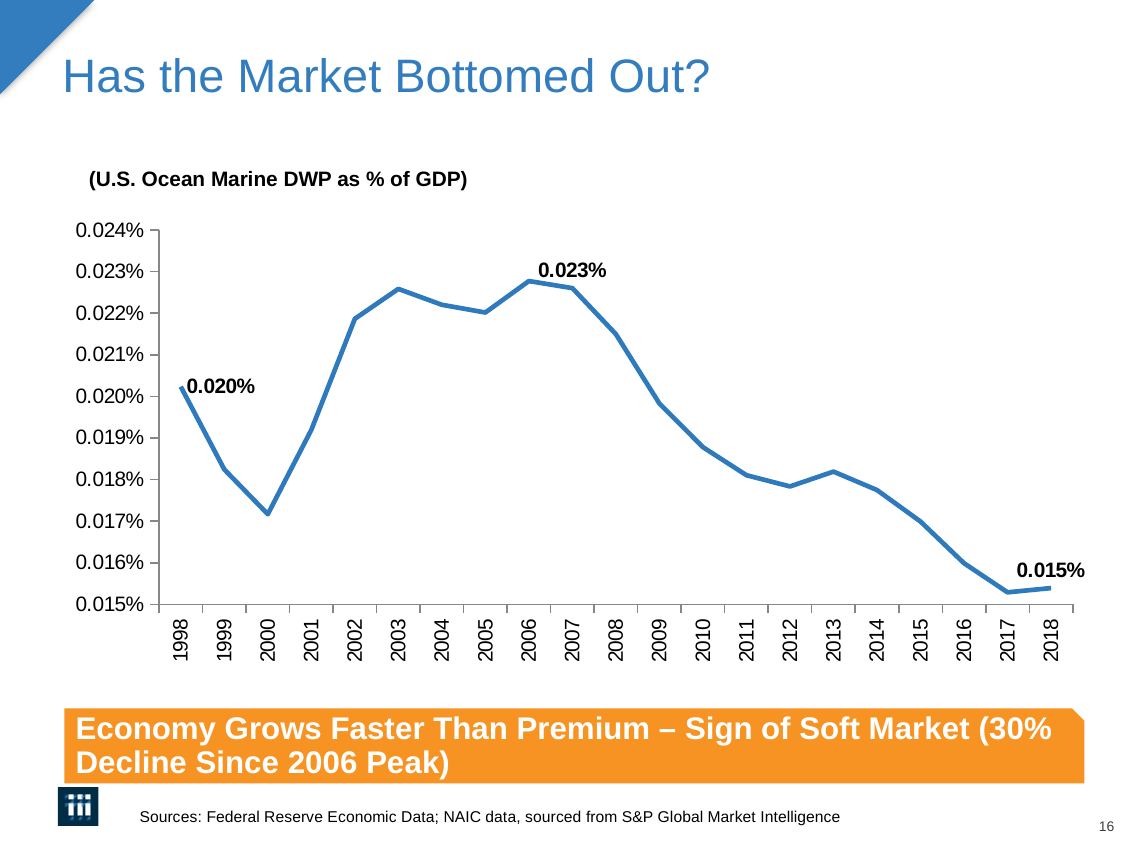
Is the value for 2003 greater or less than 0.022%? greater Which year has the highest value? 2006 What is the value for 2006? 0.023% What is the value for 2017? 0.015% Which year has the lowest value? 2017 Do the values rise or fall from 2013 to 2017? fall Which is larger, the value for 2003 or the value for 2012? 2003 What is the value for 1998? 0.020% What kind of chart is shown? line chart What is the difference between the 2006 value and the 2017 value? 0.008% Is the value for 2000 greater or less than 0.018%? less How many years are plotted on the x axis? 21